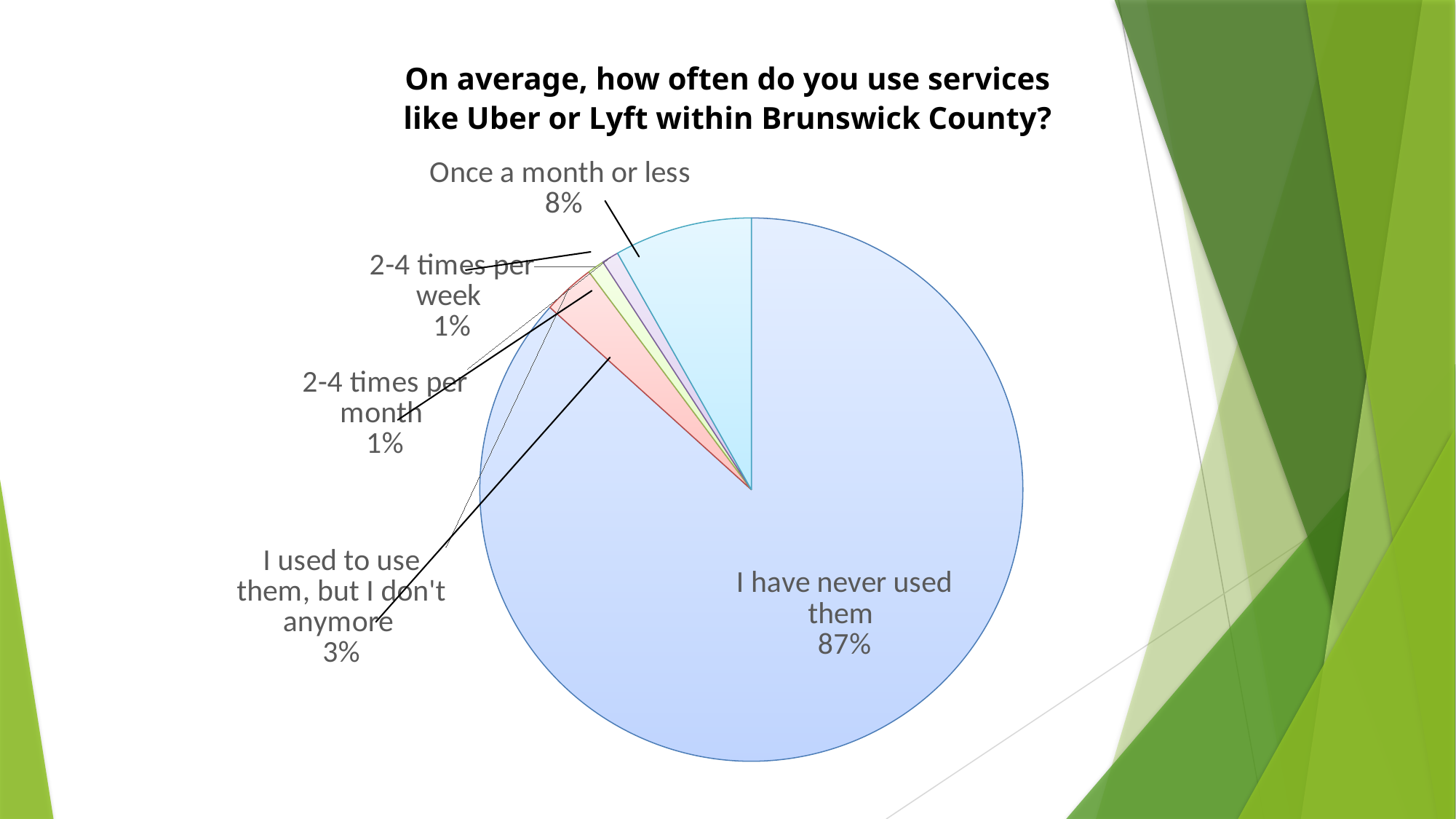
Which response category has the largest share of the pie? I have never used them What is the difference in percentage points between 'I have never used them' and 'Once a month or less'? 79 What is the title of the chart? On average, how often do you use services like Uber or Lyft within Brunswick County? Which is larger: the share for 'Once a month or less' or the share for 'I used to use them, but I don't anymore'? Once a month or less What share of respondents said they used to use them but don't anymore? 3% What percentage of respondents use these services 2-4 times per month? 1% What percentage of respondents use services like Uber or Lyft once a month or less? 8% What percentage of respondents use these services 2-4 times per week? 1% What is the combined share of the two categories labelled 1% each? 2% What type of chart is shown on the slide? Pie chart What share of respondents said they have never used services like Uber or Lyft within Brunswick County? 87% How many response categories are shown in the pie chart? 5